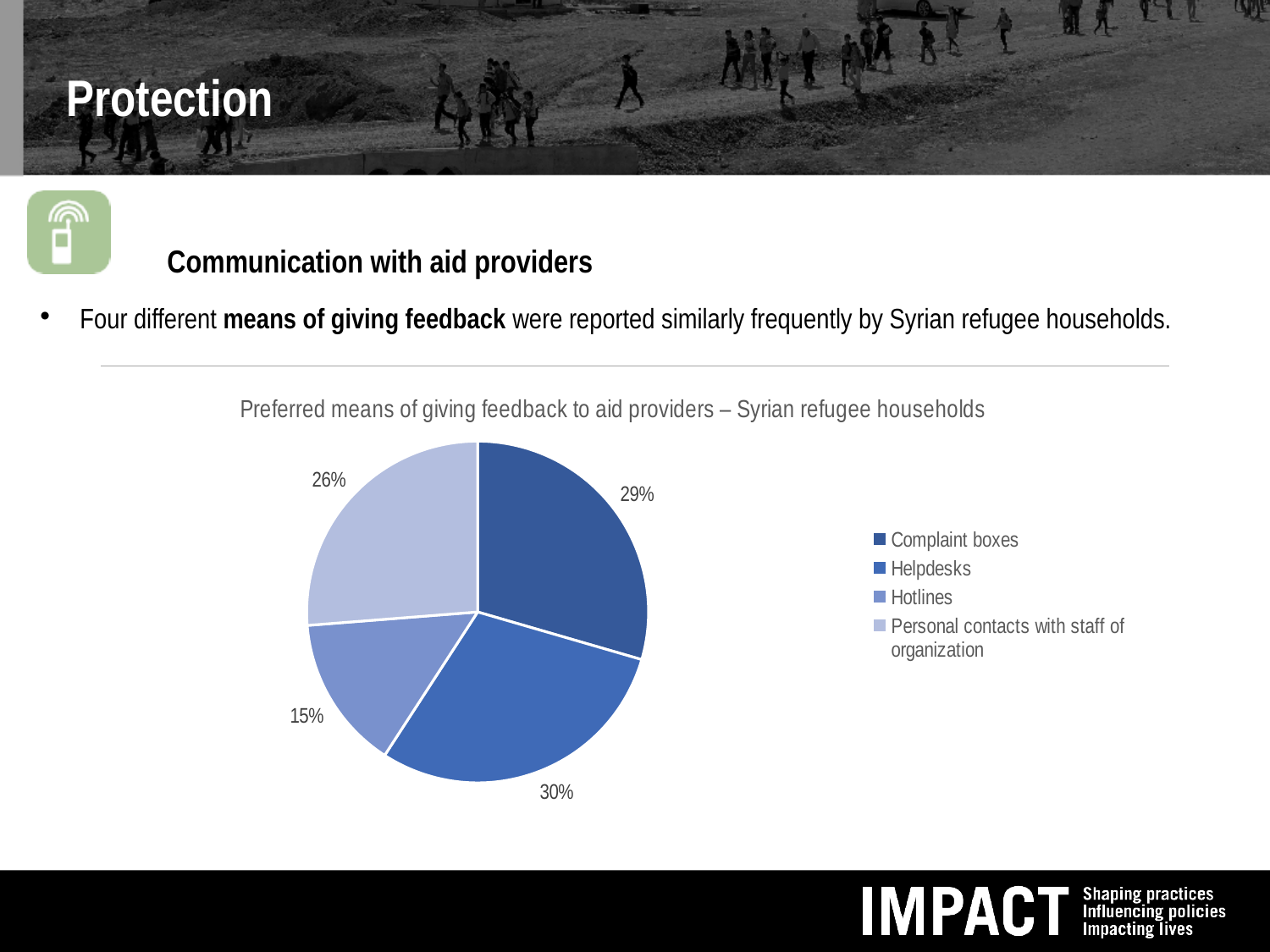
What is the difference in percentage points between helpdesks and hotlines? 15 What type of chart is shown on the slide? pie chart Which means of giving feedback has the smallest share of the pie? Hotlines Which is larger, the share for complaint boxes or the share for personal contacts with staff of organization? Complaint boxes What percentage of Syrian refugee households preferred complaint boxes as a means of giving feedback? 29% What percentage is shown for hotlines? 15% What share of the pie is labelled for helpdesks? 30% What is the title of the pie chart? Preferred means of giving feedback to aid providers – Syrian refugee households Which legend entry is shown in the lightest shade of blue? Personal contacts with staff of organization How many slices does the pie chart have? 4 What percentage is shown for personal contacts with staff of organization? 26% Which means of giving feedback has the largest share of the pie? Helpdesks